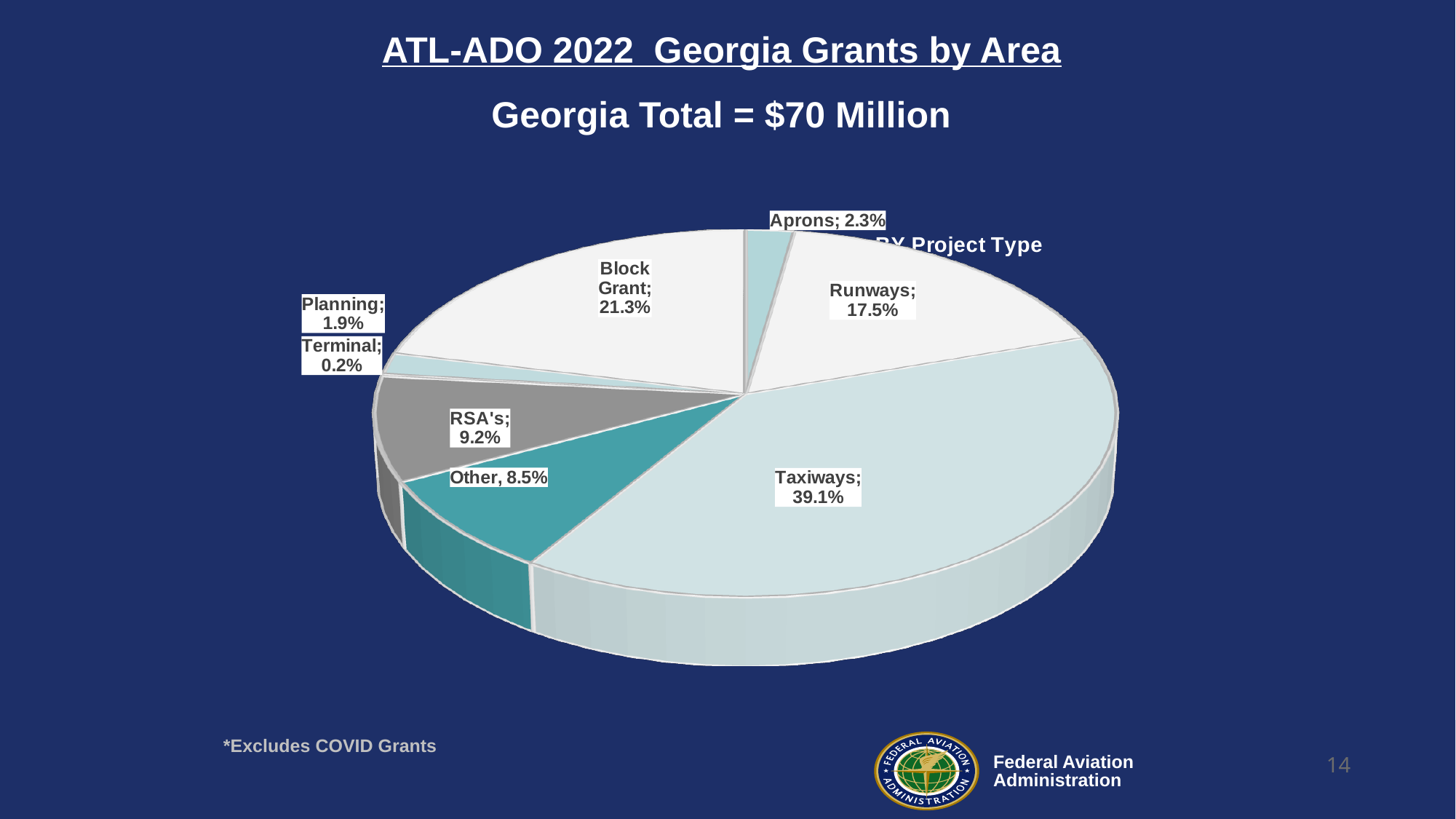
How many slices does the pie chart have? 8 What percentage is shown for Block Grant? 21.3% What is the Georgia total stated on the slide? $70 Million What percentage is shown for RSA's? 9.2% What percentage is shown for Terminal? 0.2% What is the difference in percentage points between Taxiways and Block Grant? 17.8 Which has a larger share, RSA's or Other? RSA's Which project type has the largest share of the pie? Taxiways What share of the pie does Taxiways represent? 39.1% What percentage is shown for Runways? 17.5% What kind of chart is shown on the slide? pie chart Which project type has the smallest share of the pie? Terminal